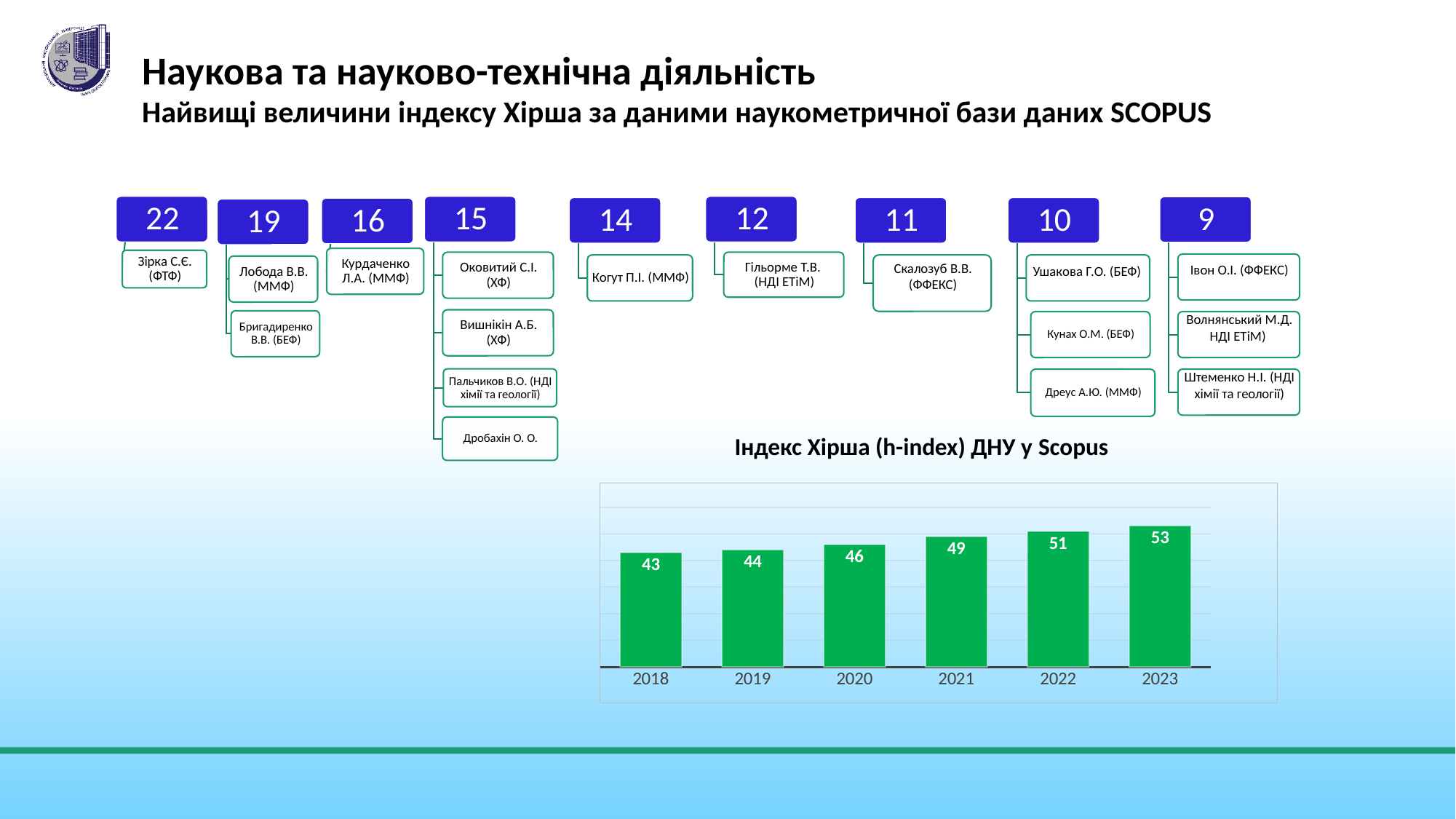
What is the title of the chart? Індекс Хірша (h-index) ДНУ у Scopus Which year has the highest h-index value in the chart? 2023 Which year has the lowest h-index value in the chart? 2018 What kind of chart is used to show the h-index values? bar chart What is the h-index value shown for 2021? 49 How many years are shown on the x axis of the chart? 6 Which year has a larger h-index value, 2019 or 2020? 2020 What is the h-index value shown for 2023? 53 What is the difference between the h-index values for 2022 and 2020? 5 What is the difference between the h-index values for 2023 and 2018? 10 Do the h-index values rise or fall from 2018 to 2023? rise What is the h-index value shown for 2018? 43